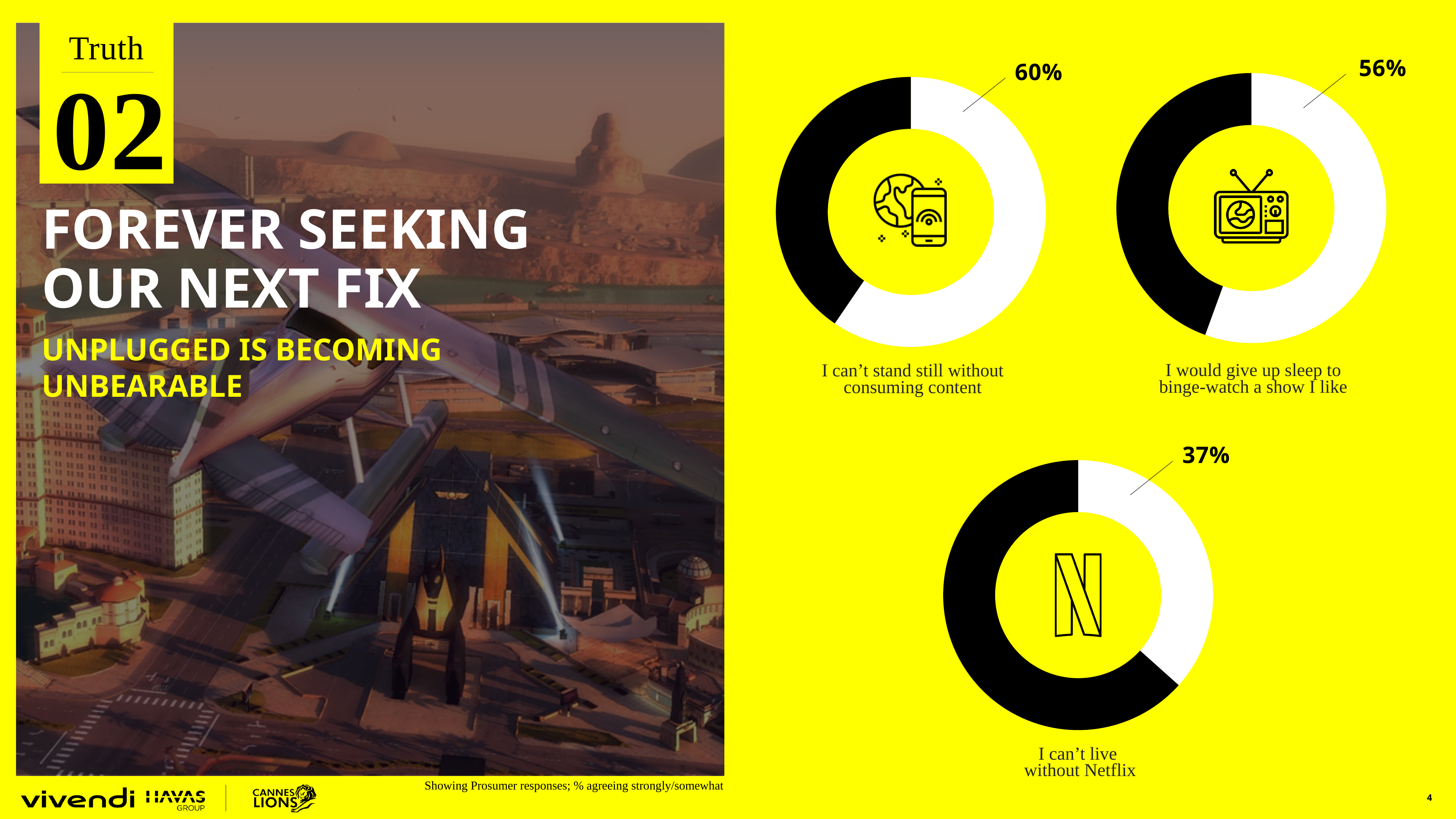
What percentage of Prosumers agree with "I can't live without Netflix"? 37% What percentage of Prosumers agree with "I would give up sleep to binge-watch a show I like"? 56% What is the difference in percentage points between "I can't stand still without consuming content" and "I would give up sleep to binge-watch a show I like"? 4 What percentage of Prosumers agree with "I can't stand still without consuming content"? 60% What is the difference in percentage points between "I can't stand still without consuming content" and "I can't live without Netflix"? 23 Which has a higher percentage agreeing: "I would give up sleep to binge-watch a show I like" or "I can't live without Netflix"? I would give up sleep to binge-watch a show I like What does the footnote say the charts are showing? Prosumer responses; % agreeing strongly/somewhat Which of the three statements on the slide has the lowest percentage agreeing? I can't live without Netflix Which of the three statements on the slide has the highest percentage agreeing? I can't stand still without consuming content How many donut charts are shown on the slide? 3 What kind of chart is used to show the percentages on the right side of the slide? Donut chart What colour is the filled portion of each donut chart? Black